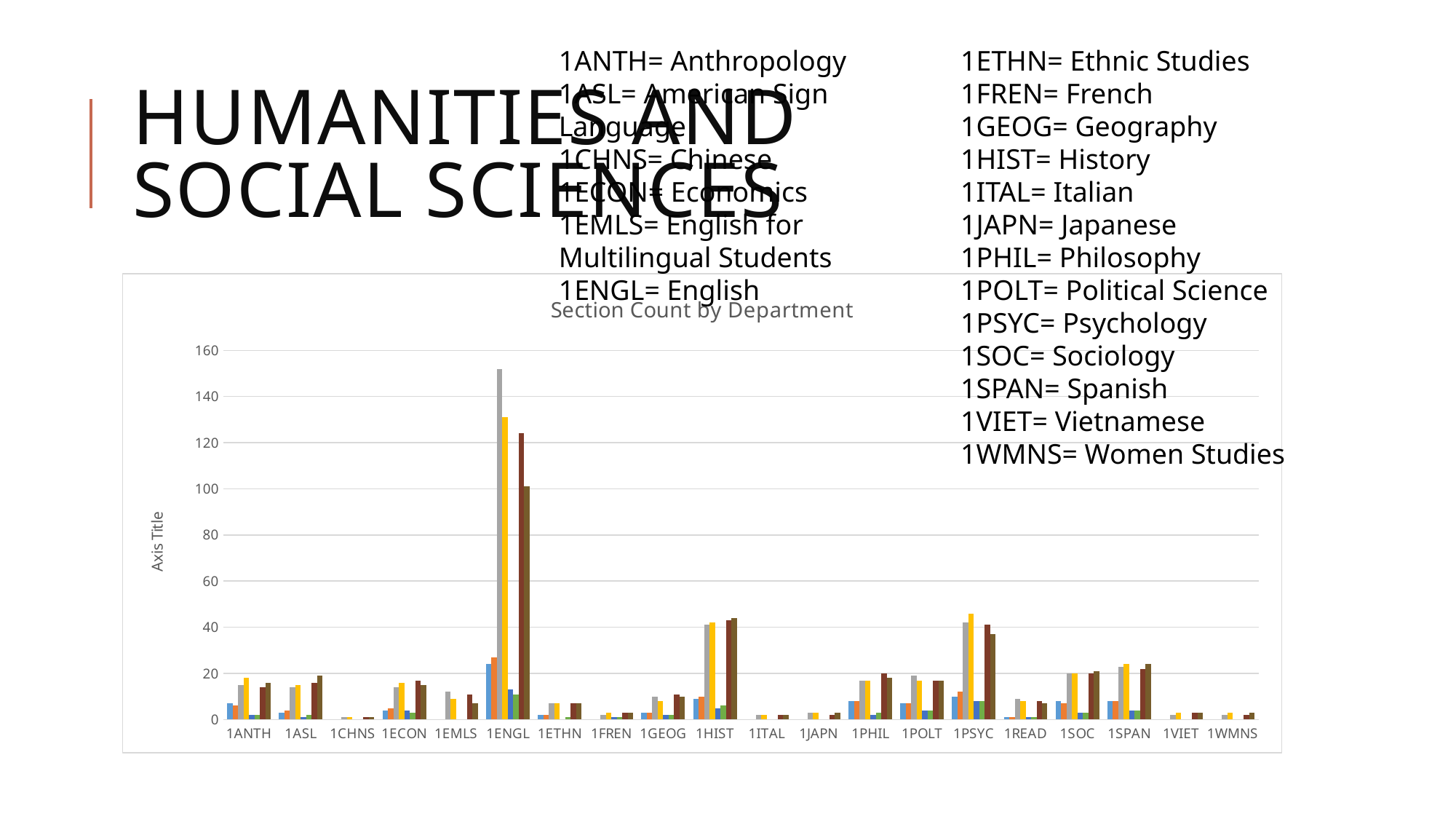
What kind of chart is shown on the slide? bar chart Which department has a taller maximum bar, 1ENGL or 1HIST? 1ENGL Which department has the tallest bar in the chart? 1ENGL What label is shown on the vertical axis of the chart? Axis Title Is the tallest bar for 1ANTH greater or less than 40? less Which department has a taller maximum bar, 1HIST or 1SPAN? 1HIST Is the tallest bar for 1ENGL greater or less than 140? greater Is the tallest bar for 1SPAN greater or less than 40? less How many departments are shown along the x axis of the chart? 20 What is the title of the chart? Section Count by Department